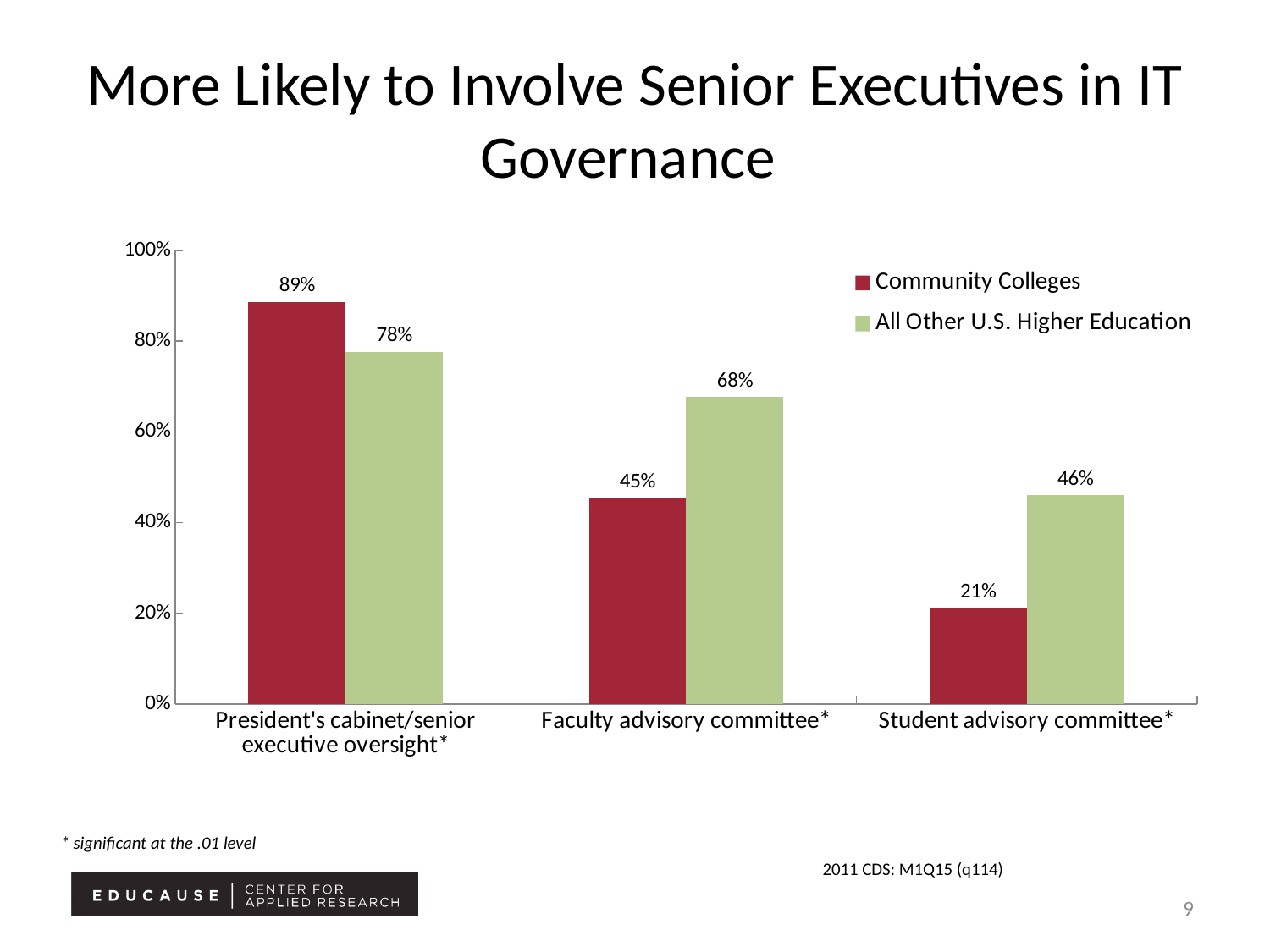
What kind of chart is shown on the slide? bar chart How many series does the legend list? 2 Which category has the highest value for All Other U.S. Higher Education? President's cabinet/senior executive oversight* How many categories are shown on the x axis? 3 What is the difference between All Other U.S. Higher Education and Community Colleges for Faculty advisory committee*? 23% Is the value for Community Colleges for Faculty advisory committee* greater or less than 40%? greater Which colour represents Community Colleges in the chart? red What is the value for All Other U.S. Higher Education for Faculty advisory committee*? 68% Which is larger for Student advisory committee*: Community Colleges or All Other U.S. Higher Education? All Other U.S. Higher Education What is the value for Community Colleges for President's cabinet/senior executive oversight*? 89% What is the value for Community Colleges for Student advisory committee*? 21% Which category has the lowest value for Community Colleges? Student advisory committee*